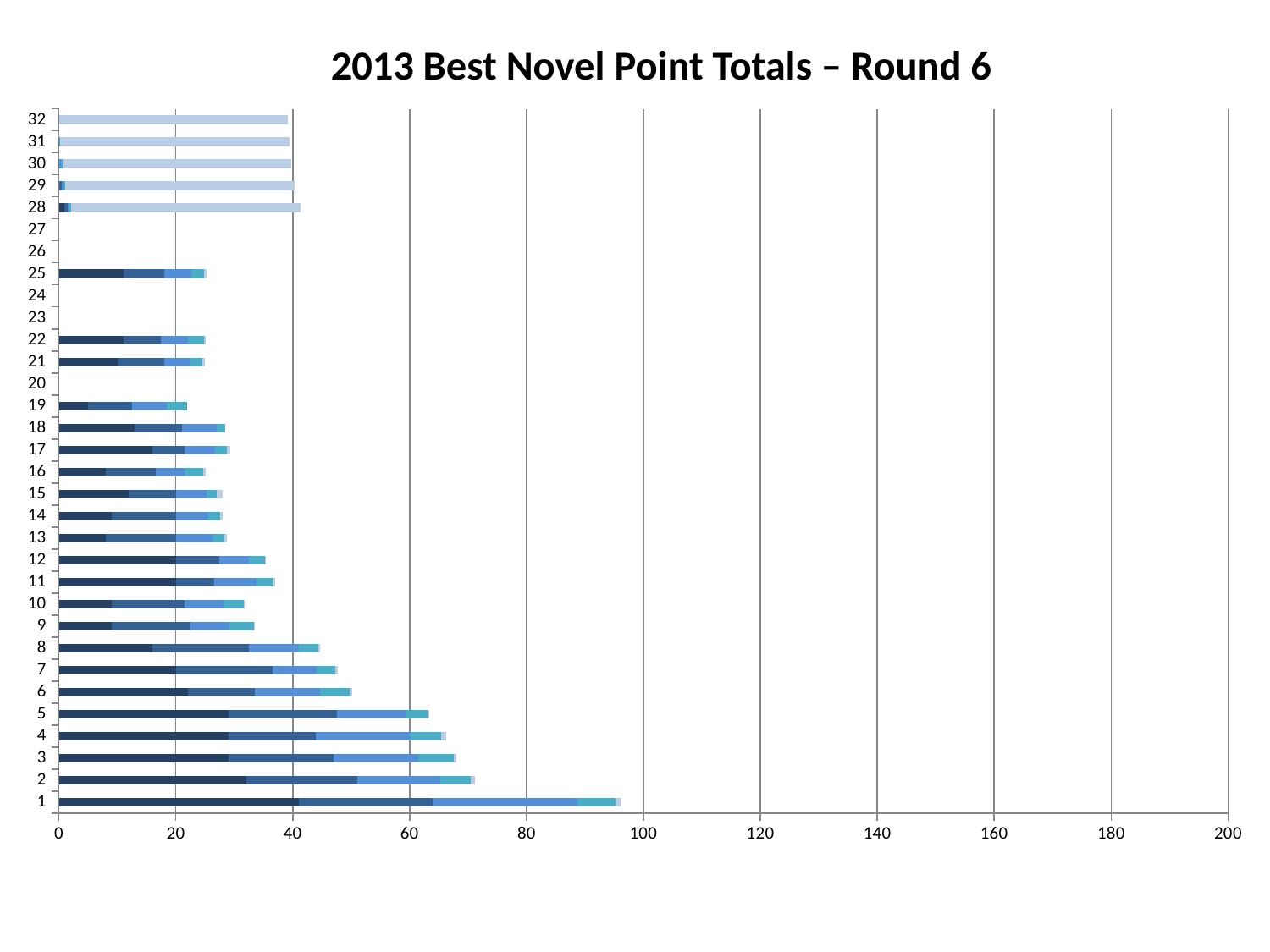
What kind of chart is shown on the slide? Stacked bar chart Is the total for category 3 greater or less than 80? less What is the highest value shown on the horizontal axis? 200 What is the title of the chart? 2013 Best Novel Point Totals – Round 6 How many categories are listed on the vertical axis of the chart? 32 Is the total for category 1 greater or less than 80? greater Which has the larger total, category 1 or category 2? 1 Is the total for category 1 greater or less than 100? less Which category has the longest bar in the chart? 1